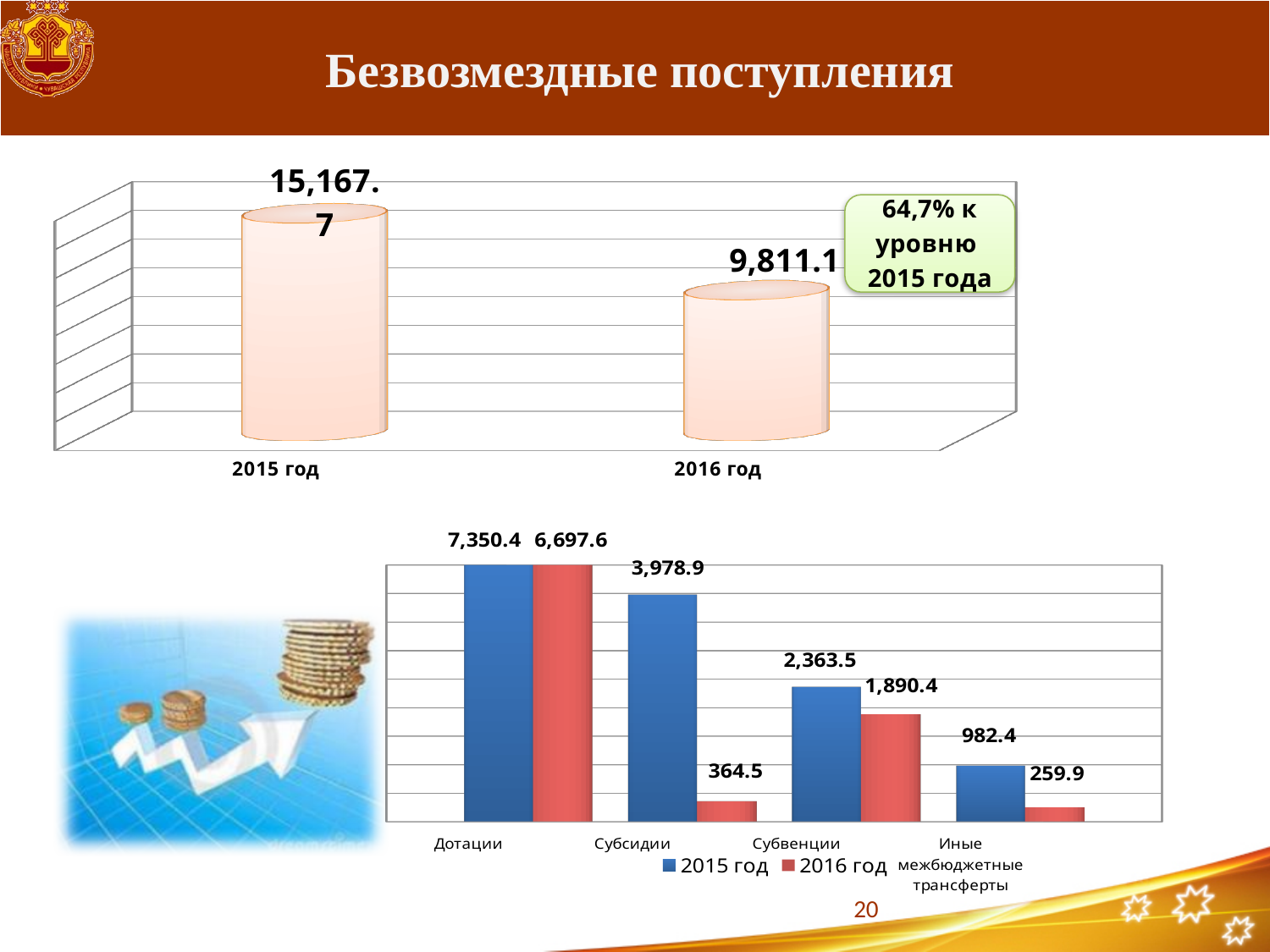
In the top chart, what is the value for 2015 год? 15,167.7 In the bottom chart, what is the 2016 год value for Субвенции? 1,890.4 How many series does the legend of the bottom chart list? 2 How many categories are shown on the x axis of the bottom chart? 4 In the bottom chart, what is the 2015 год value for Дотации? 7,350.4 In the bottom chart, what is the 2016 год value for Субсидии? 364.5 In the bottom chart, which category has the lowest 2016 год value? Иные межбюджетные трансферты In the top chart, what is the value for 2016 год? 9,811.1 In the bottom chart, what is the difference between the 2015 год and 2016 год values for Субсидии? 3,614.4 In the top chart, which year has the higher value, 2015 год or 2016 год? 2015 год In the bottom chart, which category has the highest 2015 год value? Дотации In the top chart, what is the difference between the 2015 год and 2016 год values? 5,356.6